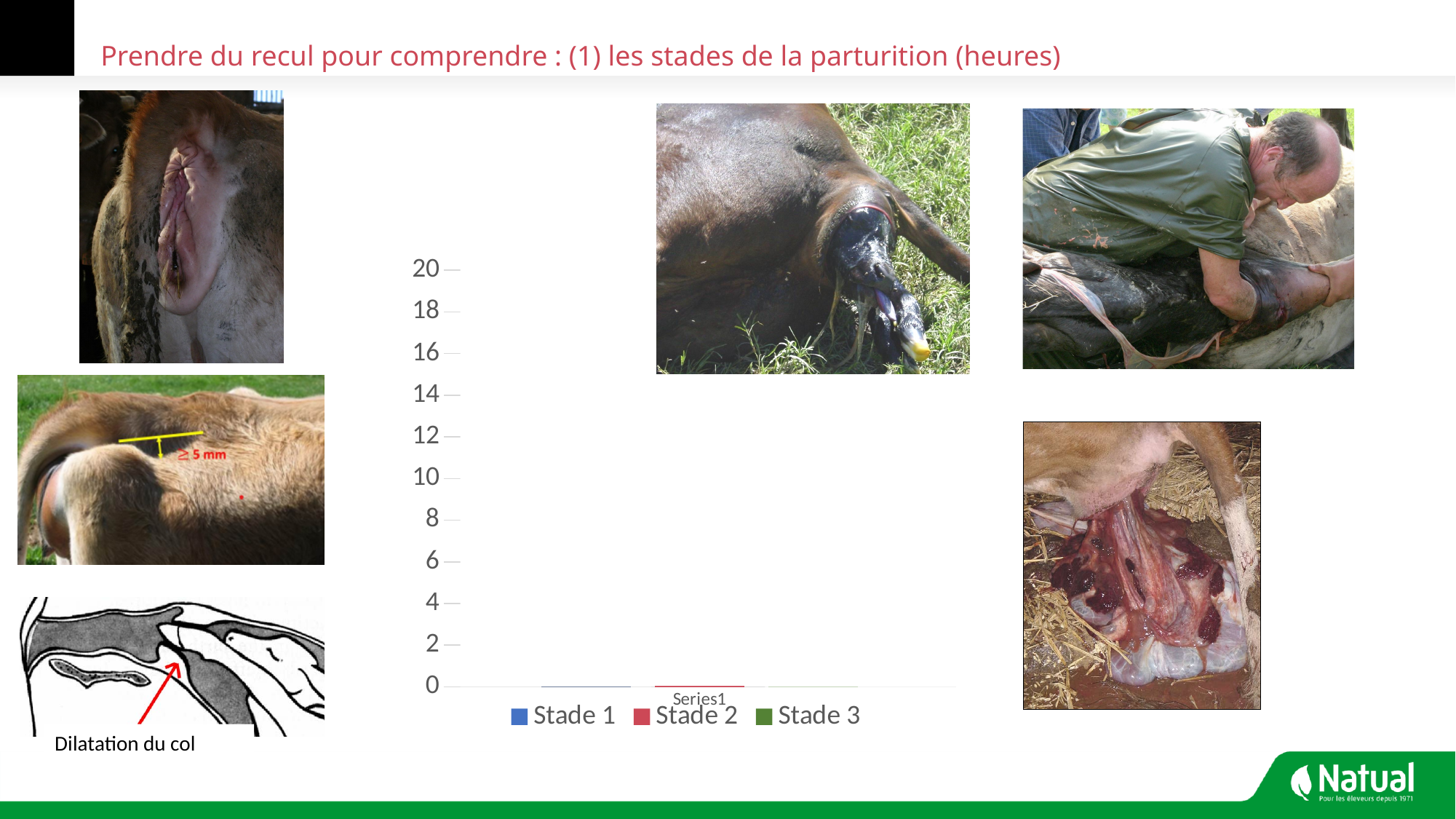
How many series does the chart legend list? 3 How many categories are shown on the chart's x axis? 1 What kind of chart is shown in the middle of the slide? bar chart What is the highest value shown on the chart's y axis? 20 What are the names of the series listed in the chart legend? Stade 1, Stade 2, Stade 3 What is the label of the category on the chart's x axis? Series1